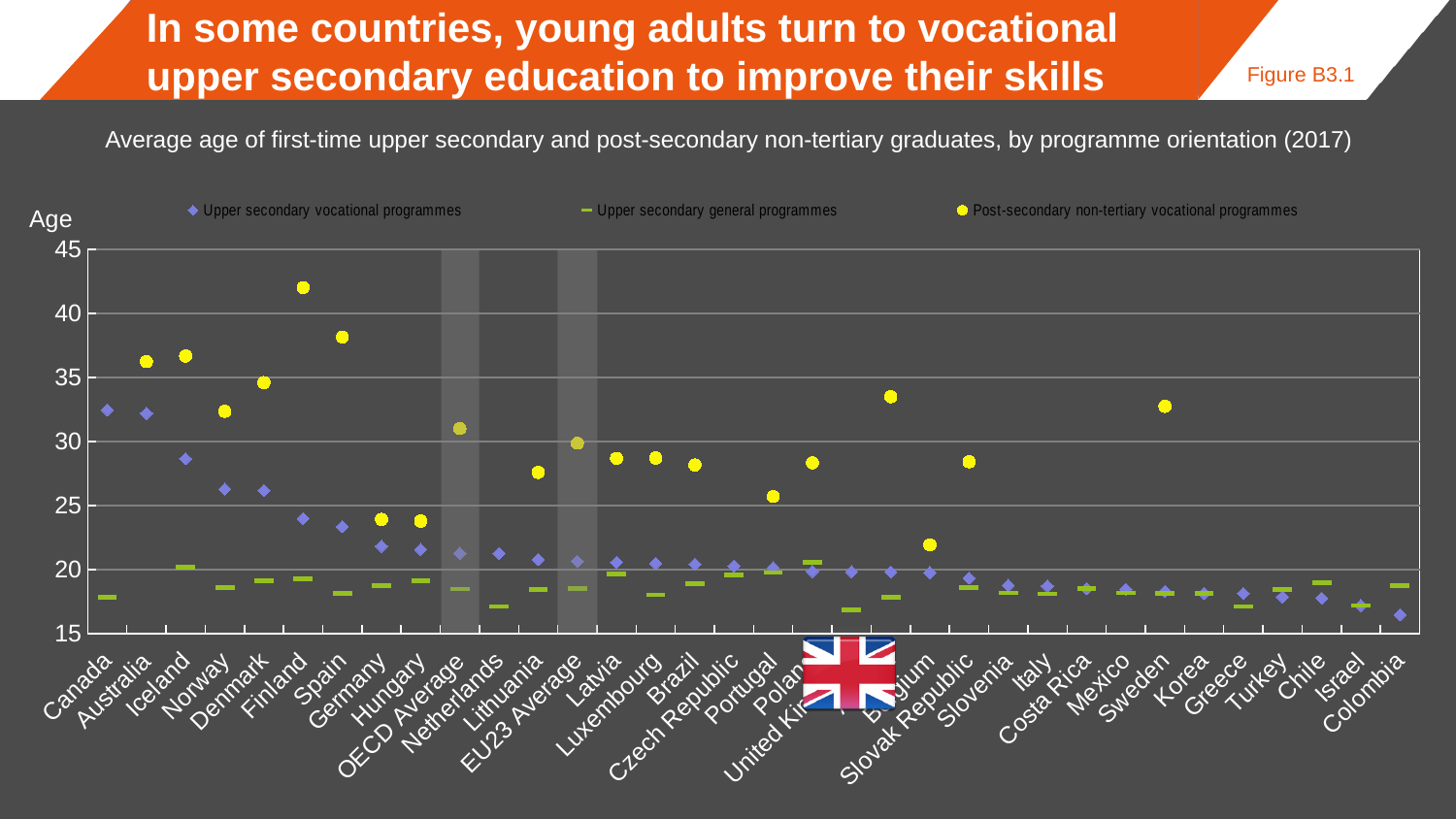
Is the value for Spain in post-secondary non-tertiary vocational programmes greater or less than 35? greater Is the value for Colombia in upper secondary vocational programmes greater or less than 20? less Is the value for Netherlands in upper secondary general programmes greater or less than 20? less How many series does the legend list? 3 Which country has the highest value for post-secondary non-tertiary vocational programmes? Finland What is the label on the vertical axis of the chart? Age What kind of chart is shown on the slide? Scatter (dot) chart Which country has the lowest value for upper secondary vocational programmes? Colombia Which is larger for post-secondary non-tertiary vocational programmes: Finland or Spain? Finland Do the values for upper secondary vocational programmes generally rise or fall from left to right along the x axis? fall